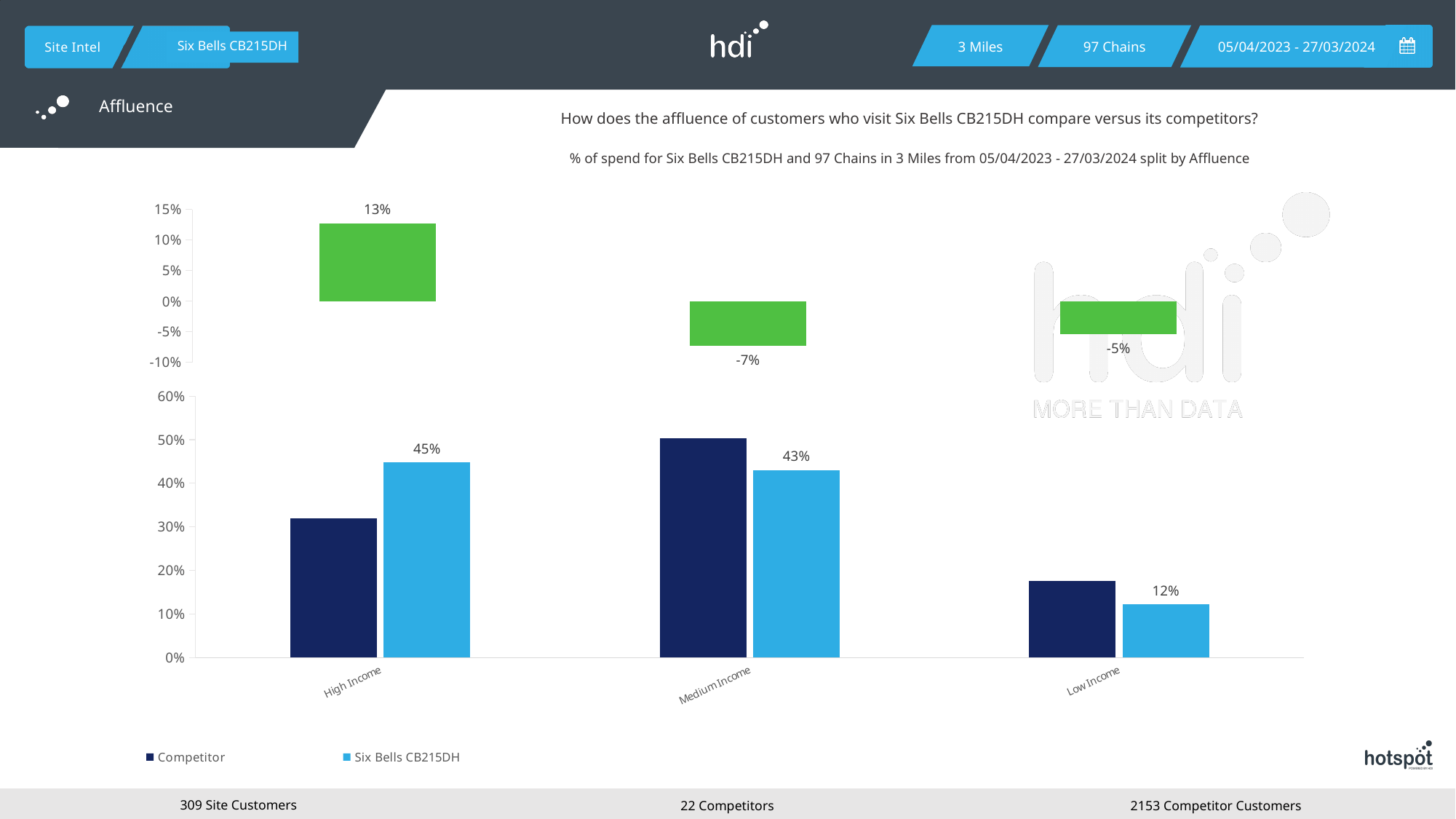
On the bottom chart, is the Competitor value for Low Income greater or less than 20%? less On the bottom chart, in the Medium Income category, which is larger: the Competitor value or the Six Bells CB215DH value? Competitor How many series does the legend of the bottom chart list? 2 On the bottom chart, what is the value for Six Bells CB215DH in the Medium Income category? 43% On the bottom chart, what is the difference between the Six Bells CB215DH values for High Income and Low Income? 33% On the bottom chart, what is the value for Six Bells CB215DH in the Low Income category? 12% On the bottom chart, what is the value for Six Bells CB215DH in the High Income category? 45% What type of chart is the bottom chart? Bar chart On the top chart, what is the value shown for the High Income category? 13% On the top chart, what is the value shown for the Medium Income category? -7% On the bottom chart, which category has the lowest value for Six Bells CB215DH? Low Income On the bottom chart, is the Competitor value for Medium Income greater or less than 40%? greater